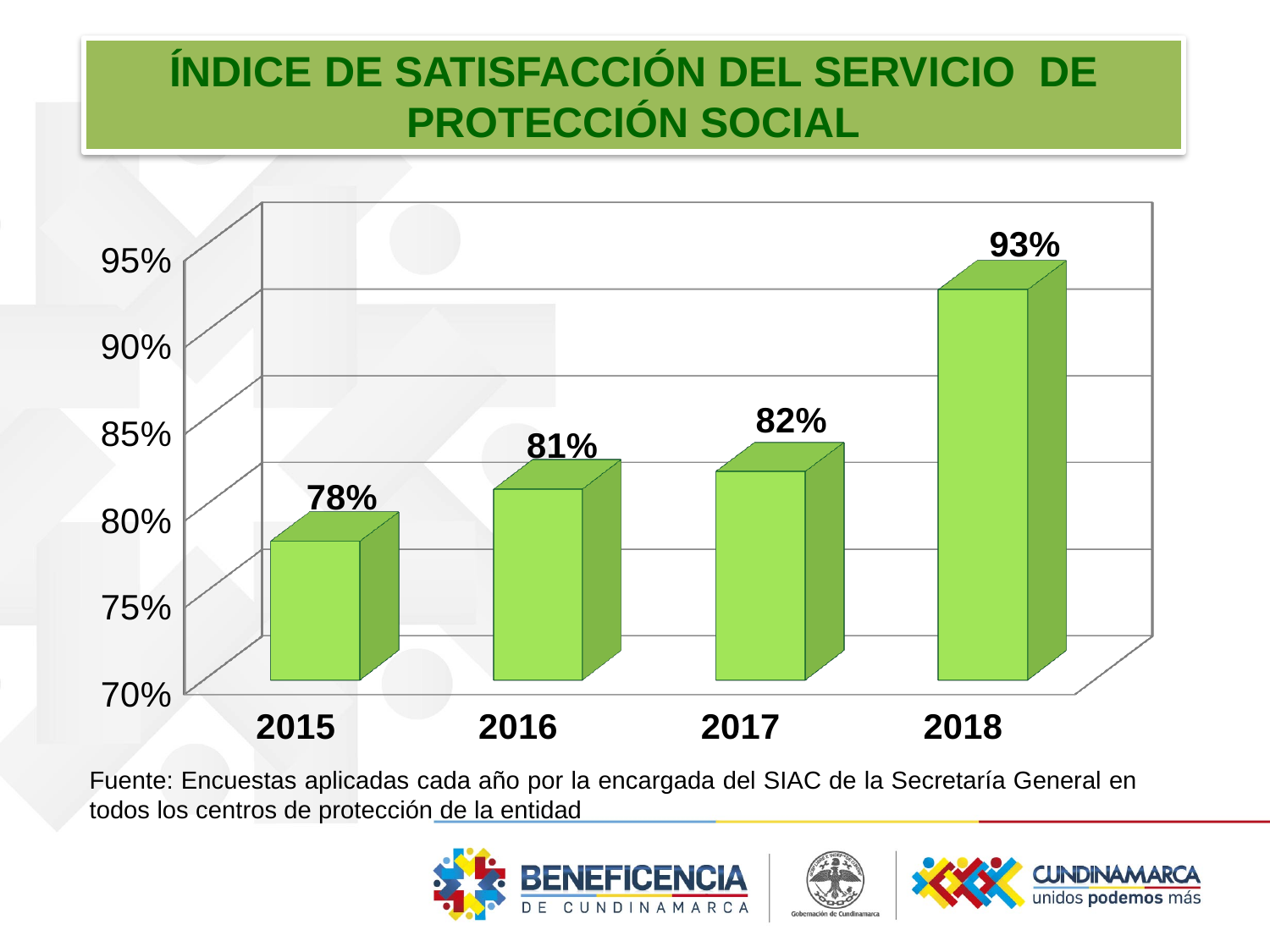
What is the difference between the 2018 and 2017 values? 11% What is the difference between the 2016 and 2015 values? 3% What is the satisfaction index value for 2015? 78% How many years are shown on the x axis? 4 Which year has the lowest satisfaction index? 2015 What kind of chart is shown on the slide? bar chart Which is larger, the value for 2016 or the value for 2018? 2018 What is the satisfaction index value for 2018? 93% Is the value for 2018 greater or less than 90%? greater Which year has the highest satisfaction index? 2018 What is the satisfaction index value for 2017? 82% Do the values rise or fall from 2015 to 2018? rise